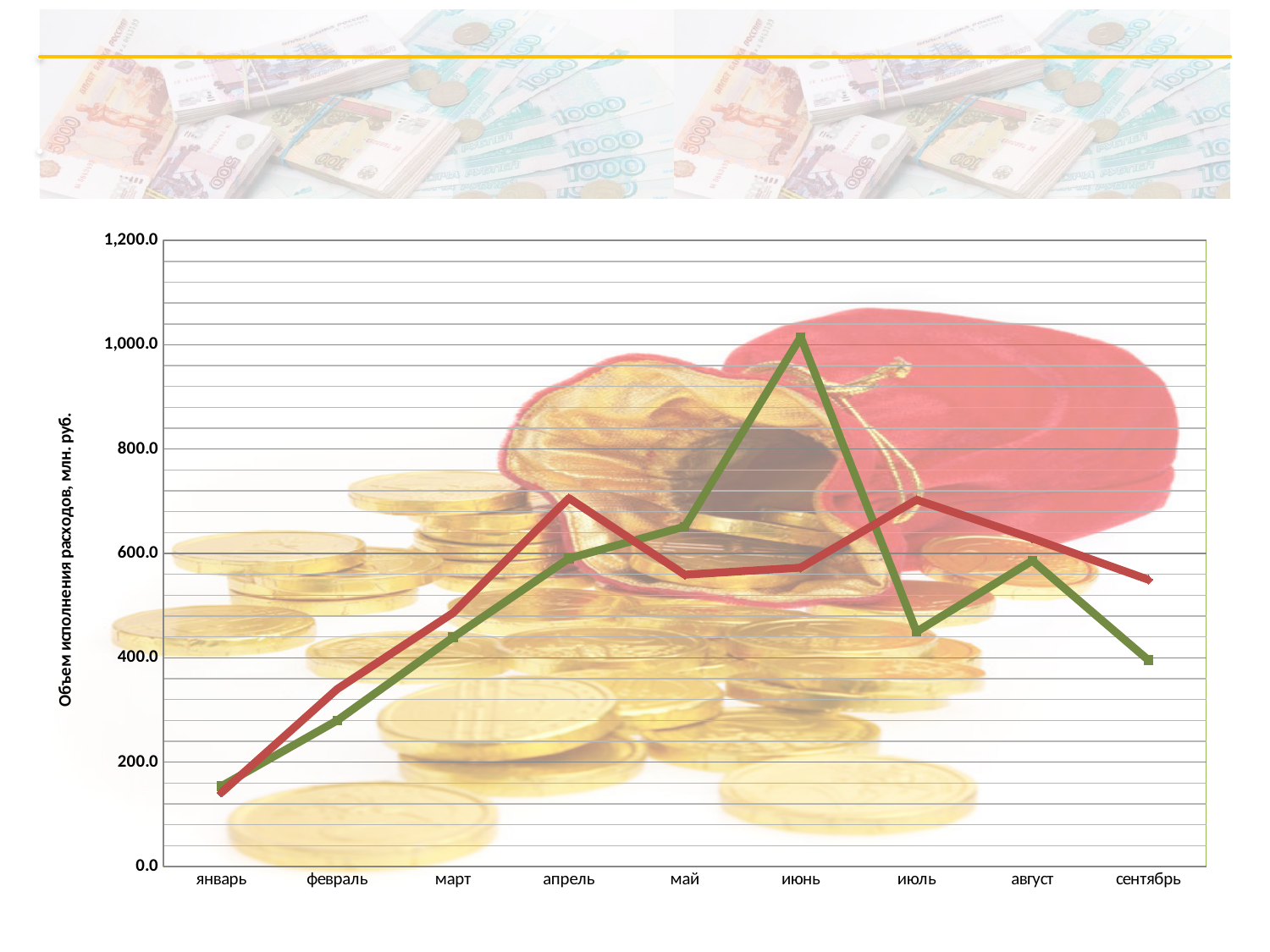
Is the value of the green line for июнь greater or less than 800? greater How many months are shown along the x axis? 9 Does the green line rise or fall from январь to июнь? rises Is the value of the red line for февраль greater or less than 400? less In which month does the green line reach its highest value? июнь In which month does the green line have its lowest value? январь In which month does the red line have its lowest value? январь In июль, which line has the higher value, the green line or the red line? red line Is the value of the green line for сентябрь greater or less than 600? less What kind of chart is shown on the slide? line chart In июнь, which line has the higher value, the green line or the red line? green line